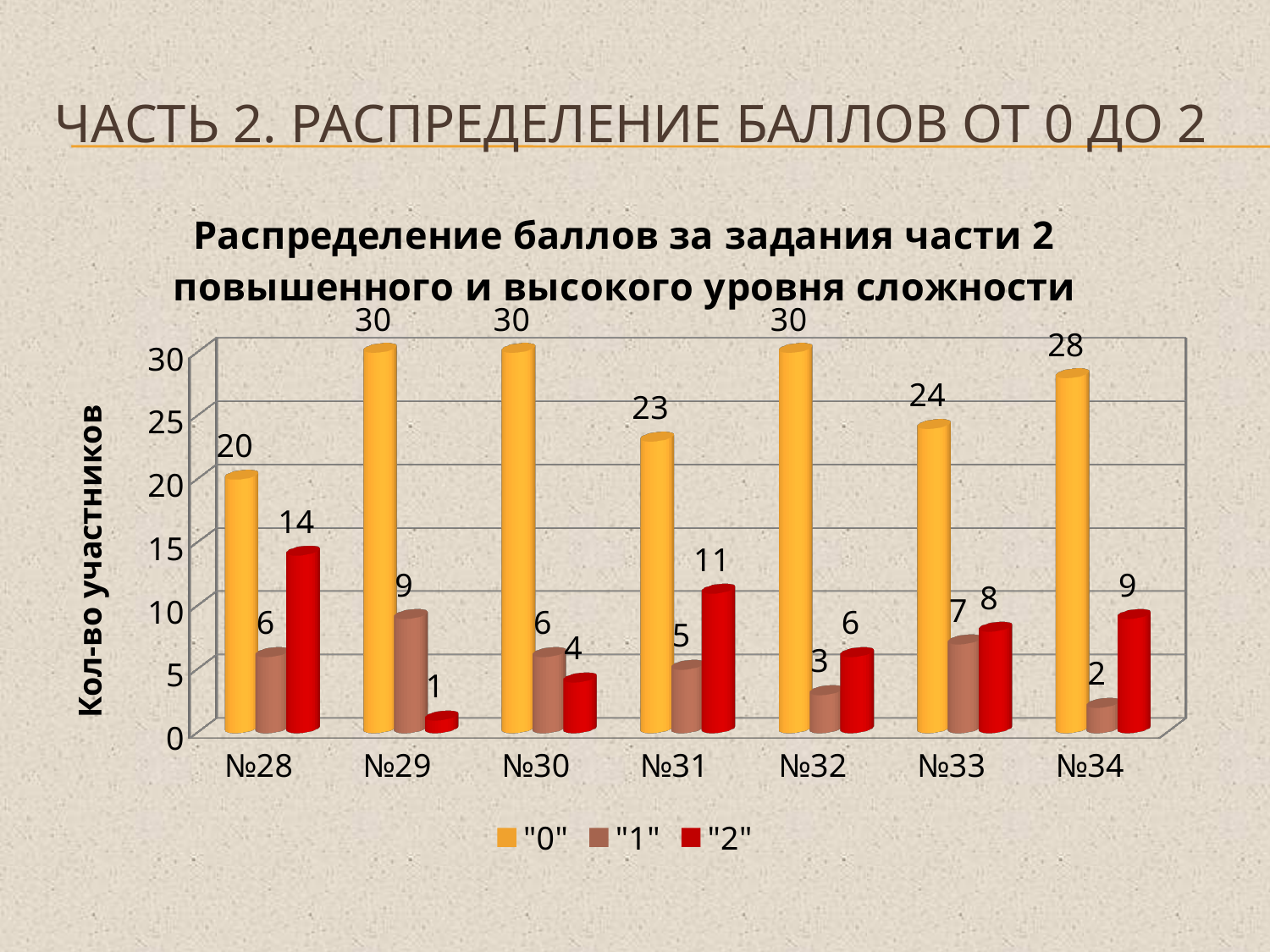
What is the value of the "2" series for №28? 14 How many categories are shown on the x axis? 7 What kind of chart is shown on the slide? Bar chart Which category has the lowest value in the "2" series? №29 What is the difference between the "0" value and the "2" value for №34? 19 What is the value of the "1" series for №29? 9 How many series does the legend list? 3 What is the value of the "0" series for №31? 23 Which category has the highest value in the "2" series? №28 Which category has the lowest value in the "0" series? №28 What is the label of the vertical axis? Кол-во участников Which is larger for №33: the "1" value or the "2" value? "2"